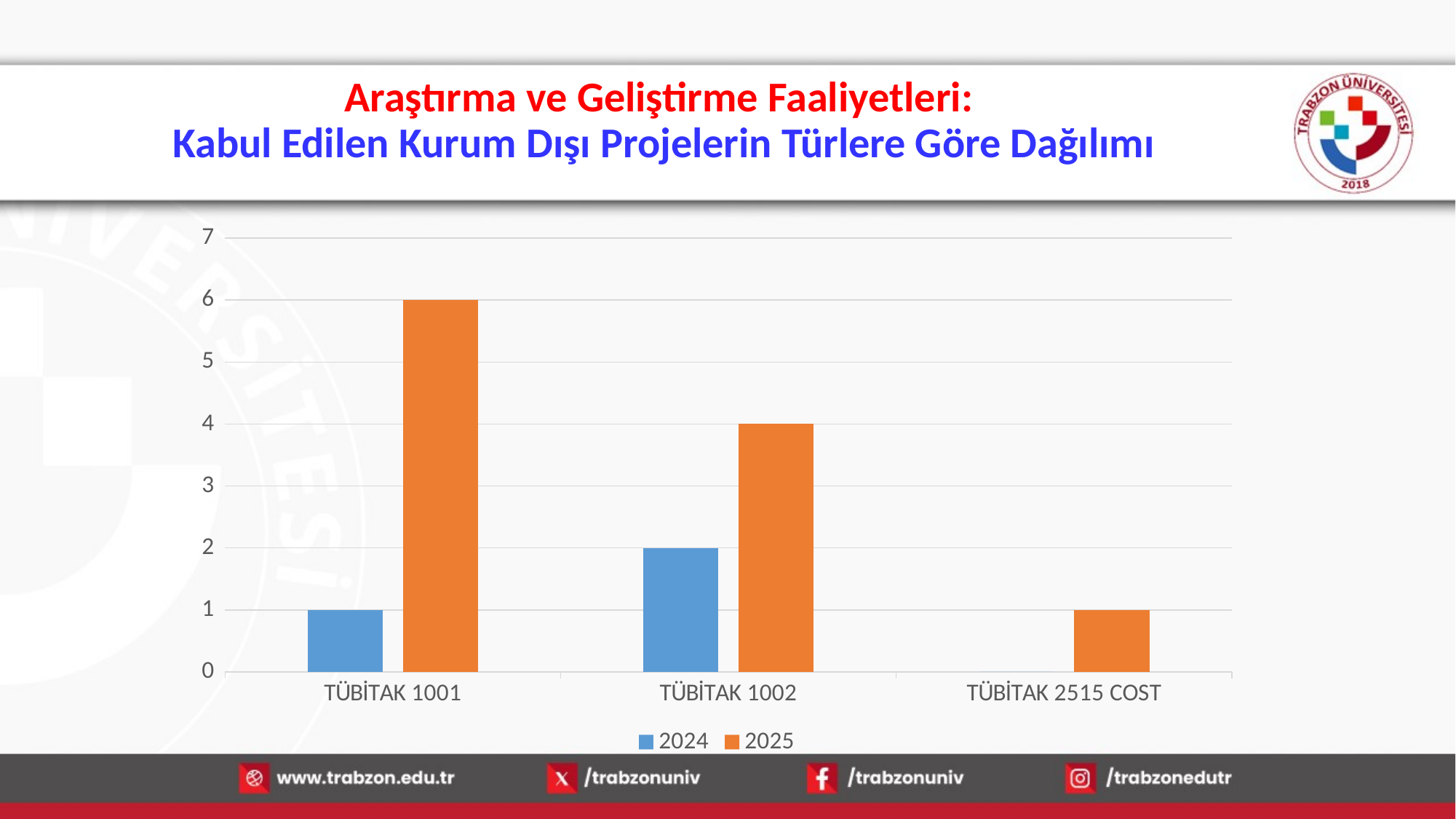
What is the 2025 value for TÜBİTAK 1001? 6 What type of chart is shown on the slide? bar chart What is the 2025 value for TÜBİTAK 1002? 4 How many categories are shown on the x axis? 3 Which is larger for TÜBİTAK 1002, the 2024 value or the 2025 value? 2025 Which category has the highest 2025 value? TÜBİTAK 1001 How many series does the legend list? 2 What is the 2024 value for TÜBİTAK 1001? 1 What is the difference between the 2025 and 2024 values for TÜBİTAK 1001? 5 What is the 2024 value for TÜBİTAK 1002? 2 What is the 2025 value for TÜBİTAK 2515 COST? 1 Which series is shown in orange in the legend? 2025